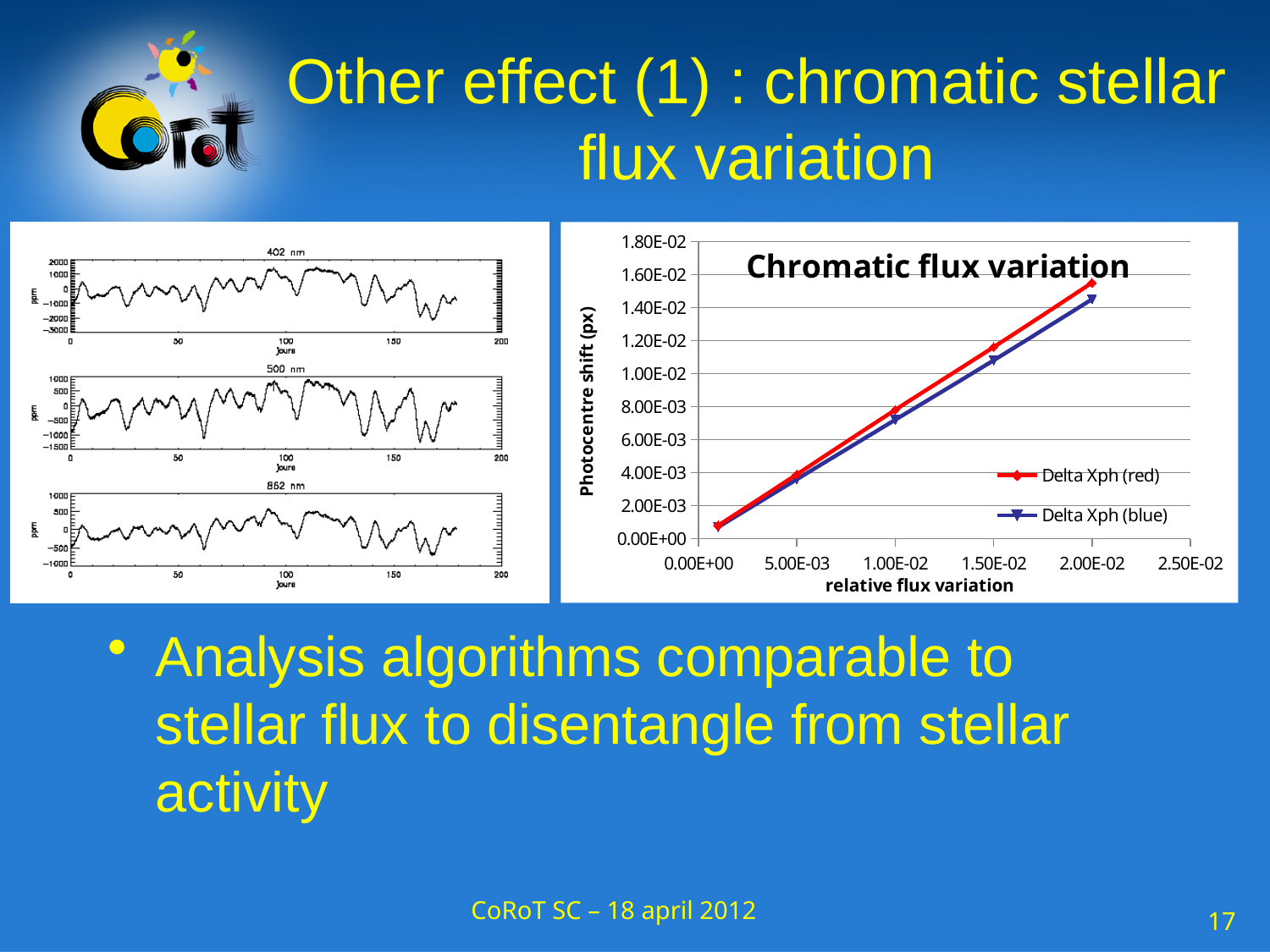
How many series does the legend of the 'Chromatic flux variation' chart list? 2 In the 'Chromatic flux variation' chart, is the value of Delta Xph (blue) at a relative flux variation of 2.00E-02 greater or less than 1.60E-02? less In the 'Chromatic flux variation' chart, which series reaches the highest photocentre shift? Delta Xph (red) In the 'Chromatic flux variation' chart, is the value of Delta Xph (blue) at a relative flux variation of 1.00E-02 greater or less than 8.00E-03? less What is the x-axis title of the 'Chromatic flux variation' chart? relative flux variation In the 'Chromatic flux variation' chart, do the values rise or fall as relative flux variation increases? rise In the 'Chromatic flux variation' chart, is the value of Delta Xph (red) at a relative flux variation of 1.50E-02 greater or less than 1.00E-02? greater In the 'Chromatic flux variation' chart, which series has the larger photocentre shift at a relative flux variation of 2.00E-02, Delta Xph (red) or Delta Xph (blue)? Delta Xph (red) What are the two legend entries in the 'Chromatic flux variation' chart? Delta Xph (red) and Delta Xph (blue) What kind of chart is the 'Chromatic flux variation' chart on the right of the slide? line chart How many data points are plotted for each series in the 'Chromatic flux variation' chart? 5